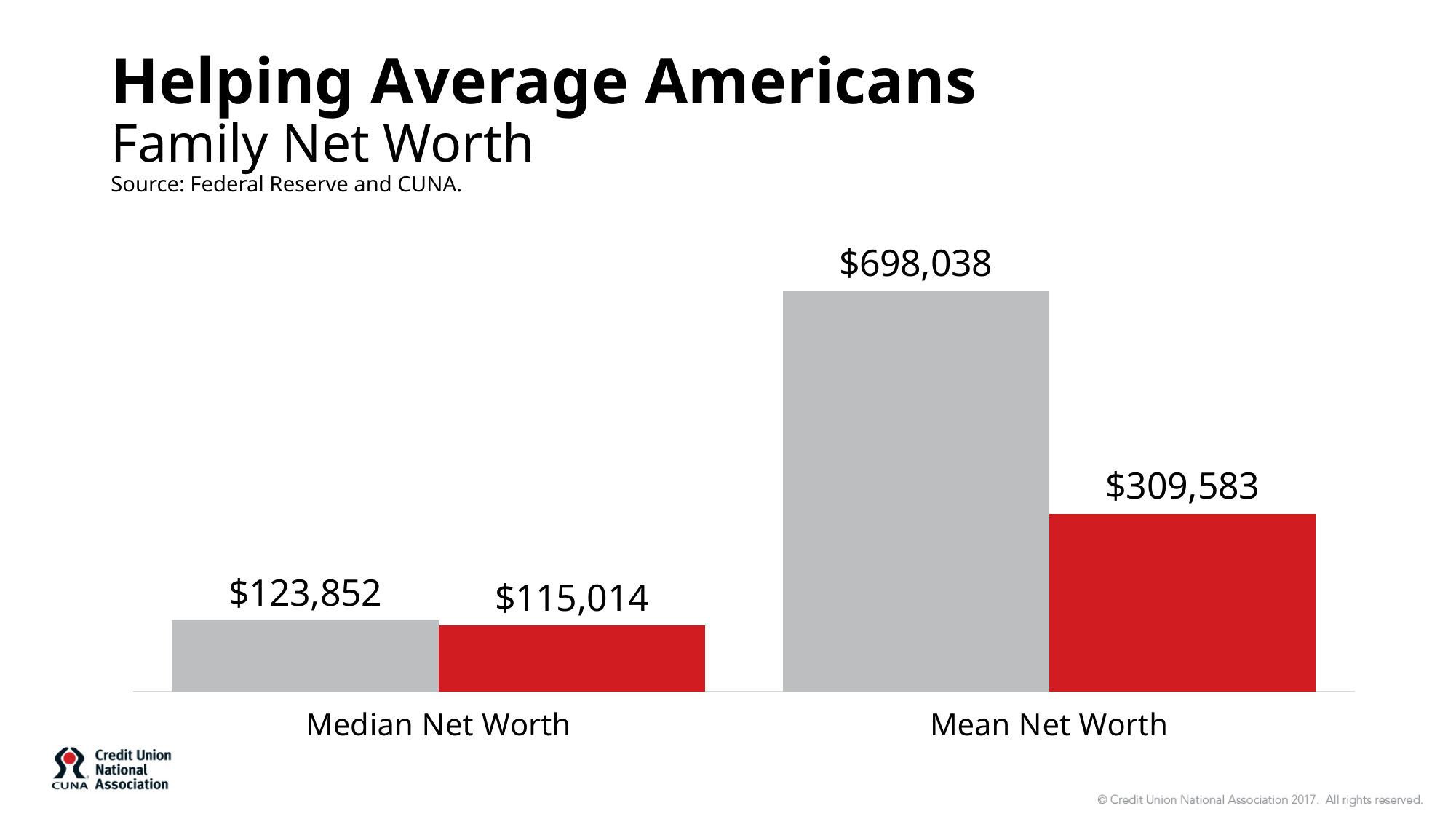
What is the subtitle of the chart on the slide? Family Net Worth What is the difference between the gray and red bars for Median Net Worth? $8,838 For Mean Net Worth, which bar is larger, the gray bar or the red bar? The gray bar What type of chart is shown on the slide? Bar chart What is the value of the red bar for Median Net Worth? $115,014 What is the value of the gray bar for Median Net Worth? $123,852 What is the difference between the gray and red bars for Mean Net Worth? $388,455 Which bar on the chart has the lowest value? The red bar for Median Net Worth ($115,014) How many categories are shown on the x axis? 2 What is the value of the red bar for Mean Net Worth? $309,583 Which bar on the chart has the highest value? The gray bar for Mean Net Worth ($698,038) What is the value of the gray bar for Mean Net Worth? $698,038